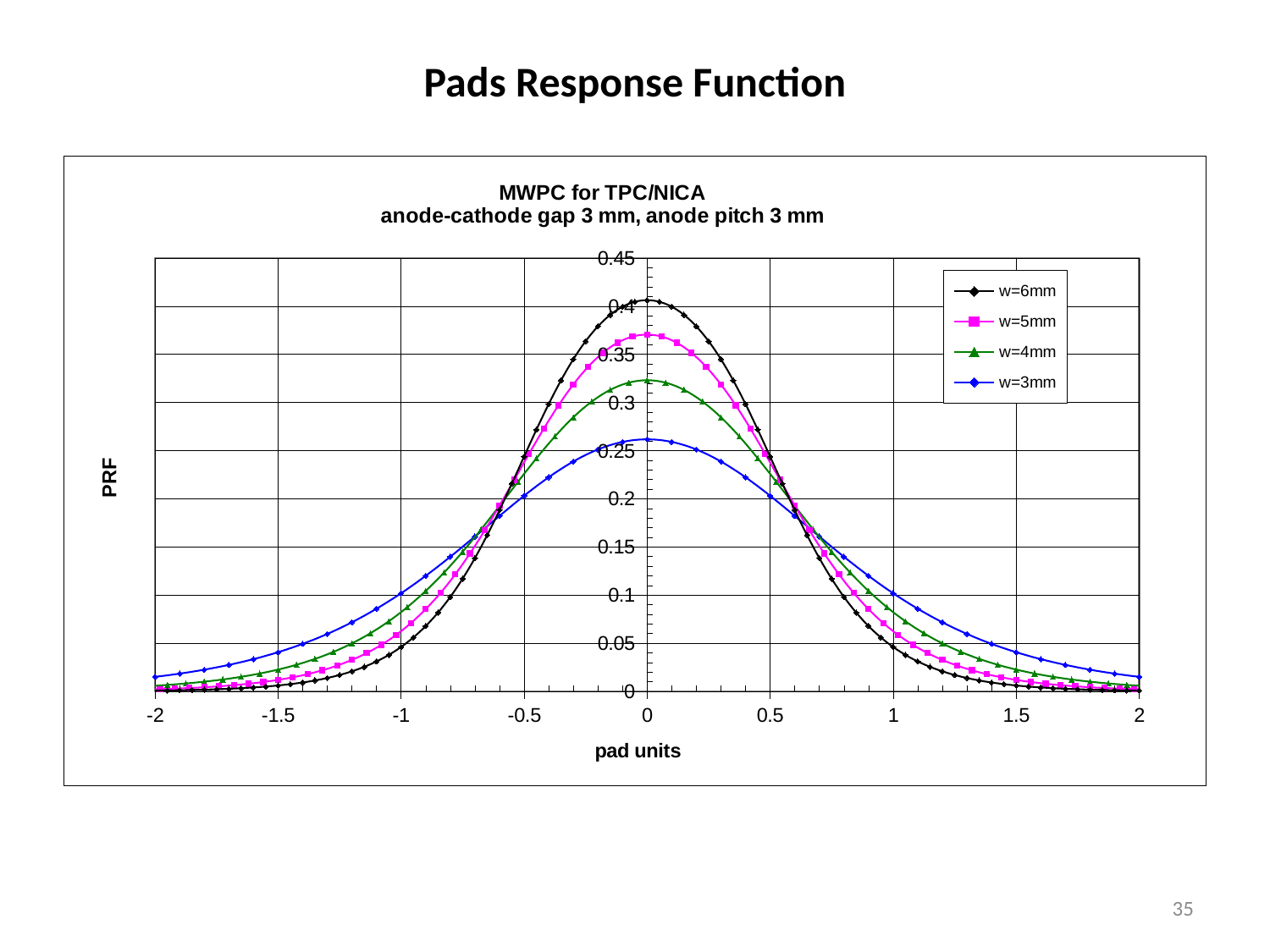
Is the PRF value for w=4mm at pad units 0 greater or less than 0.3? greater Do the PRF values rise or fall as pad units go from 0 to 2? fall What is the label of the y axis? PRF What kind of chart is shown on the slide? line chart Which series reaches the highest PRF value at pad units 0? w=6mm What is the first line of the chart title? MWPC for TPC/NICA How many series does the legend list? 4 Is the PRF value for w=6mm at pad units 1 greater or less than 0.1? less Which series has the lowest peak PRF value at pad units 0? w=3mm Is the PRF value for w=5mm at pad units 0 greater or less than 0.35? greater At pad units 0, which series has the larger PRF value, w=6mm or w=3mm? w=6mm At pad units 1.5, which series has the larger PRF value, w=3mm or w=6mm? w=3mm